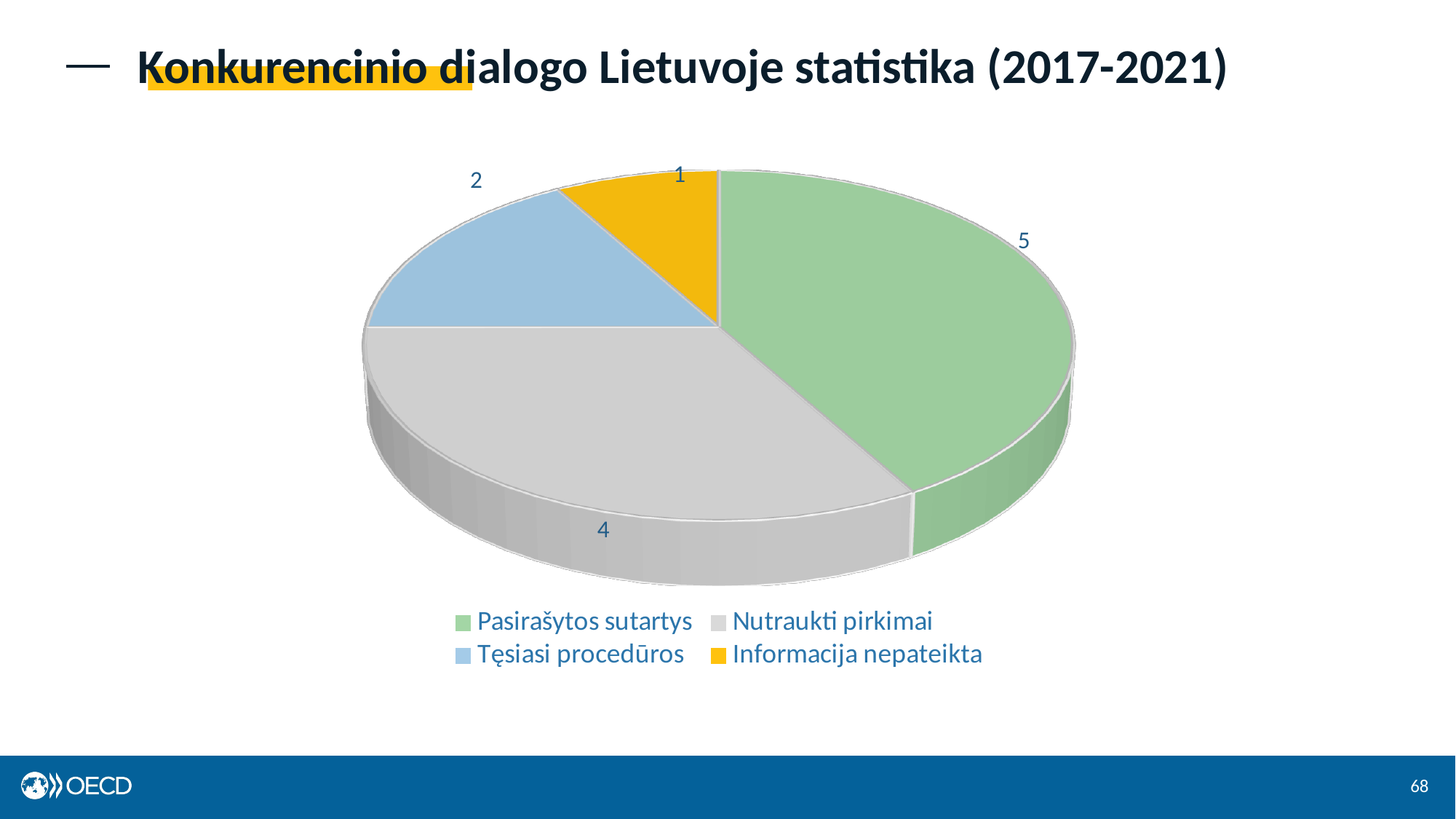
What is the value for Tęsiasi procedūros in the pie chart? 2 Which category has the largest slice in the pie chart? Pasirašytos sutartys What type of chart is shown on the slide? Pie chart What is the total of all the values shown in the pie chart? 12 How many categories are shown in the pie chart? 4 Which is larger, the value for Tęsiasi procedūros or the value for Informacija nepateikta? Tęsiasi procedūros What is the value for Pasirašytos sutartys in the pie chart? 5 What is the difference between the values for Pasirašytos sutartys and Nutraukti pirkimai? 1 Which category has the smallest slice in the pie chart? Informacija nepateikta What is the value for Nutraukti pirkimai in the pie chart? 4 What is the value for Informacija nepateikta in the pie chart? 1